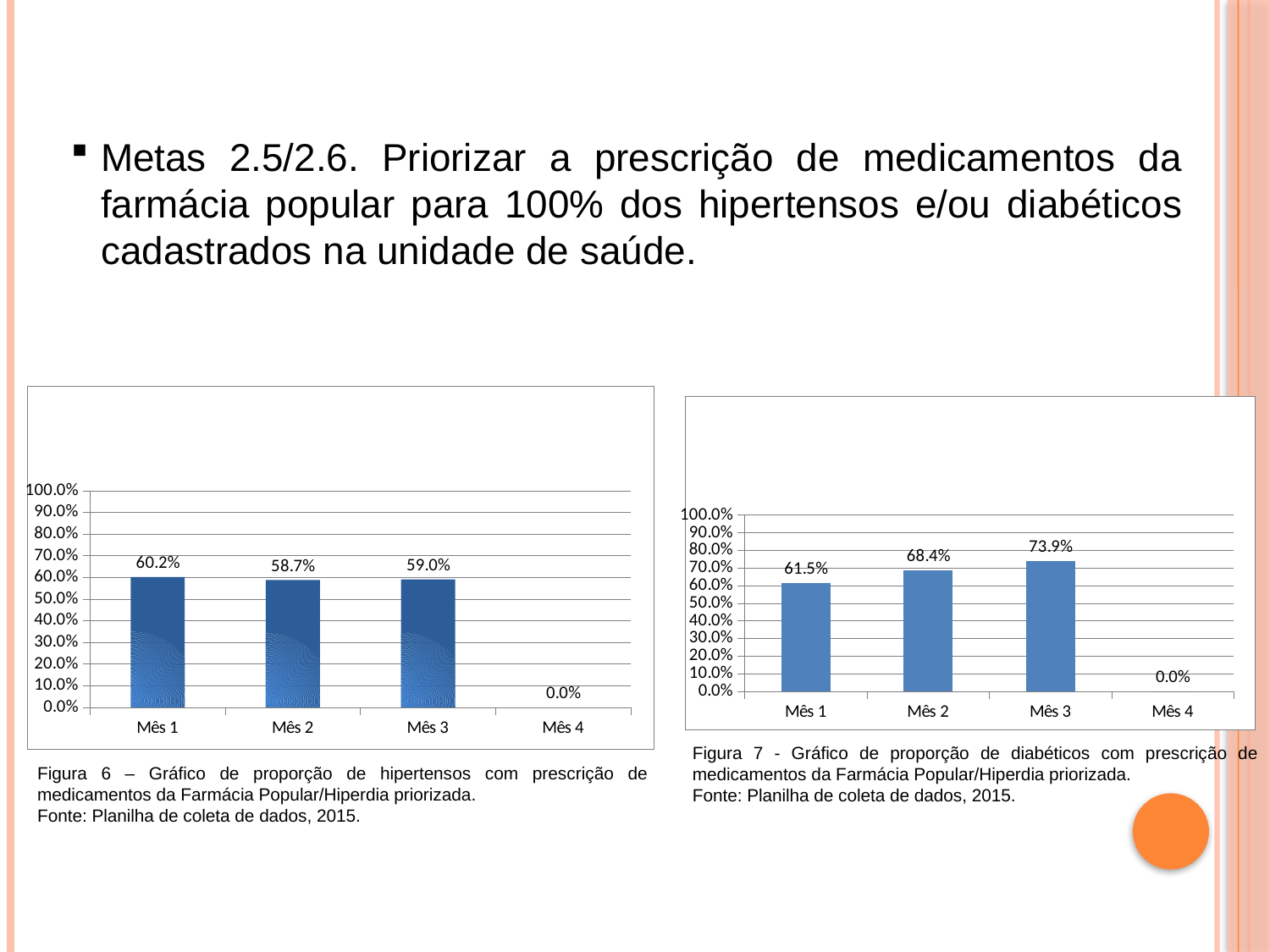
In the right chart (Figura 7, diabéticos), what is the value for Mês 3? 73.9% In the left chart (Figura 6, hipertensos), what is the value for Mês 2? 58.7% In the right chart (Figura 7, diabéticos), what is the difference between Mês 3 and Mês 1? 12.4% How many months (categories) are shown on the x axis of the left chart (Figura 6)? 4 In the right chart (Figura 7, diabéticos), what is the value for Mês 1? 61.5% In the left chart (Figura 6, hipertensos), what is the difference between Mês 1 and Mês 2? 1.5% What kind of chart is the right chart (Figura 7)? Bar chart In the right chart (Figura 7, diabéticos), which is larger, Mês 2 or Mês 1? Mês 2 In the left chart (Figura 6, hipertensos), which month has the lowest value? Mês 4 In the right chart (Figura 7, diabéticos), which month has the highest value? Mês 3 In the left chart (Figura 6, hipertensos), what is the value for Mês 1? 60.2% In the right chart (Figura 7, diabéticos), do the values rise or fall from Mês 1 to Mês 3? Rise